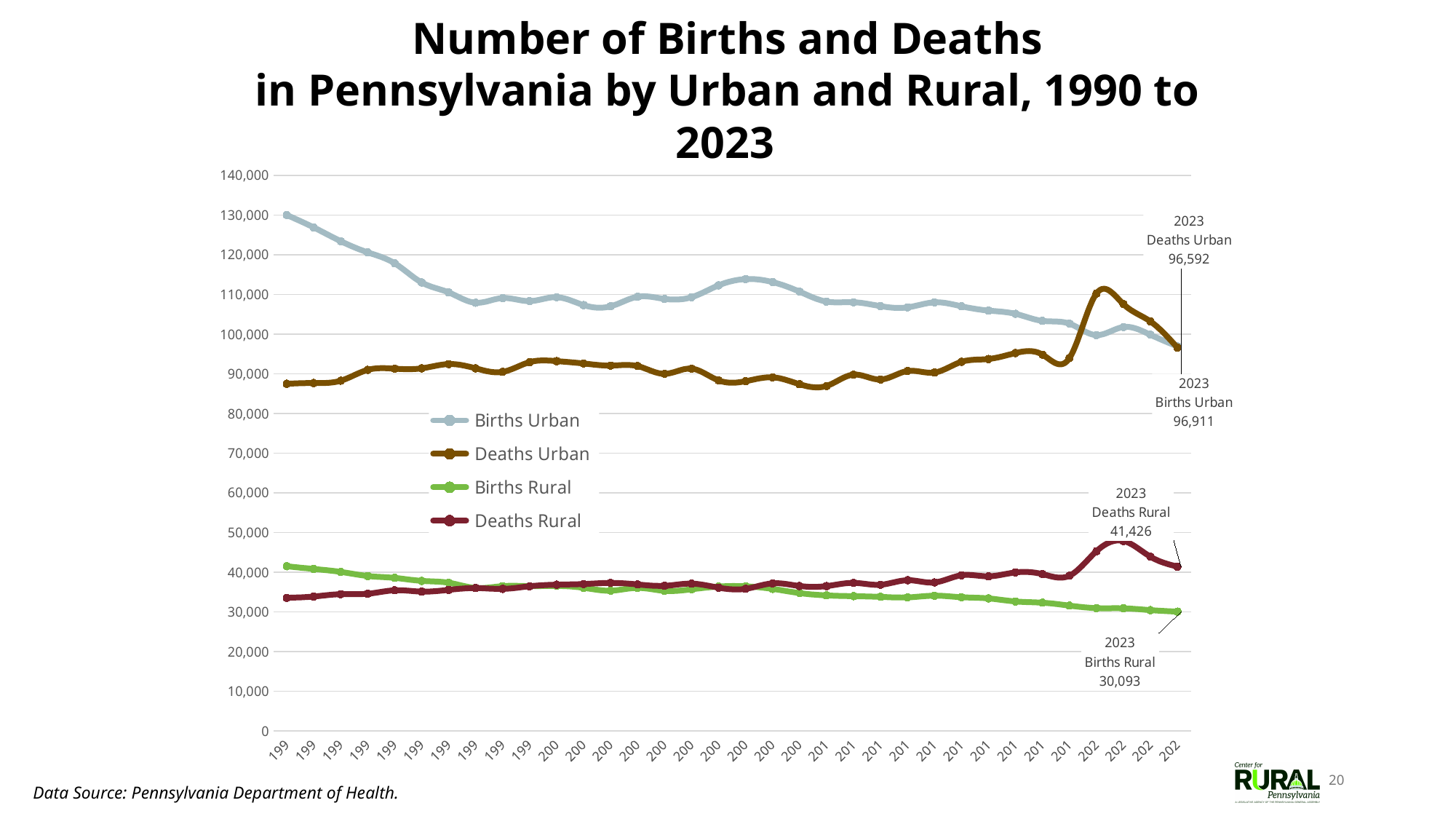
Does the Births Urban line rise or fall from 1990 to 2023? fall Is the value for Births Urban in 1990 greater or less than 120,000? greater In 2023, which is larger: Births Urban or Deaths Urban? Births Urban What is the value for Births Rural in 2023? 30,093 What data source is cited on the slide? Pennsylvania Department of Health What is the value for Deaths Urban in 2023? 96,592 What is the difference between Deaths Rural and Births Rural in 2023? 11,333 What is the value for Deaths Rural in 2023? 41,426 How many series does the legend list? 4 Which series has the lowest value in 2023? Births Rural What is the value for Births Urban in 2023? 96,911 What type of chart is shown on the slide? line chart